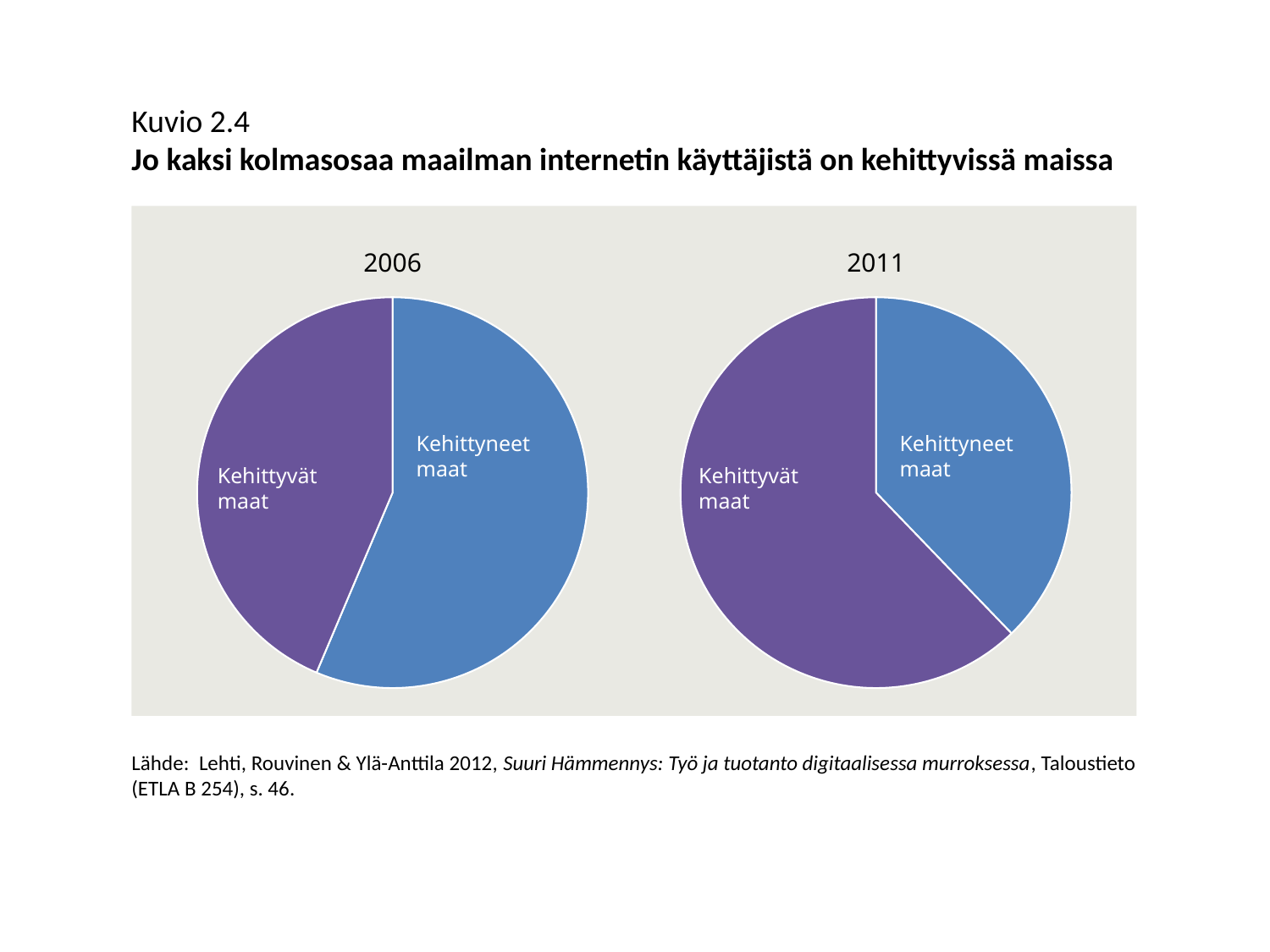
How many slices does the 2011 pie chart have? 2 In the 2011 pie chart, which category has the largest share? Kehittyvät maat In the 2011 pie chart, which slice is larger: Kehittyneet maat or Kehittyvät maat? Kehittyvät maat What are the titles of the two pie charts? 2006 and 2011 How many slices does the 2006 pie chart have? 2 What kind of chart is shown for 2011? Pie chart In the 2006 pie chart, which category has the smallest share? Kehittyvät maat How many pie charts are shown on the slide? 2 In the 2006 pie chart, which slice is larger: Kehittyneet maat or Kehittyvät maat? Kehittyneet maat What colour is the Kehittyneet maat slice in the pie charts? Blue In the 2011 pie chart, which category has the smallest share? Kehittyneet maat What kind of chart is shown for 2006? Pie chart